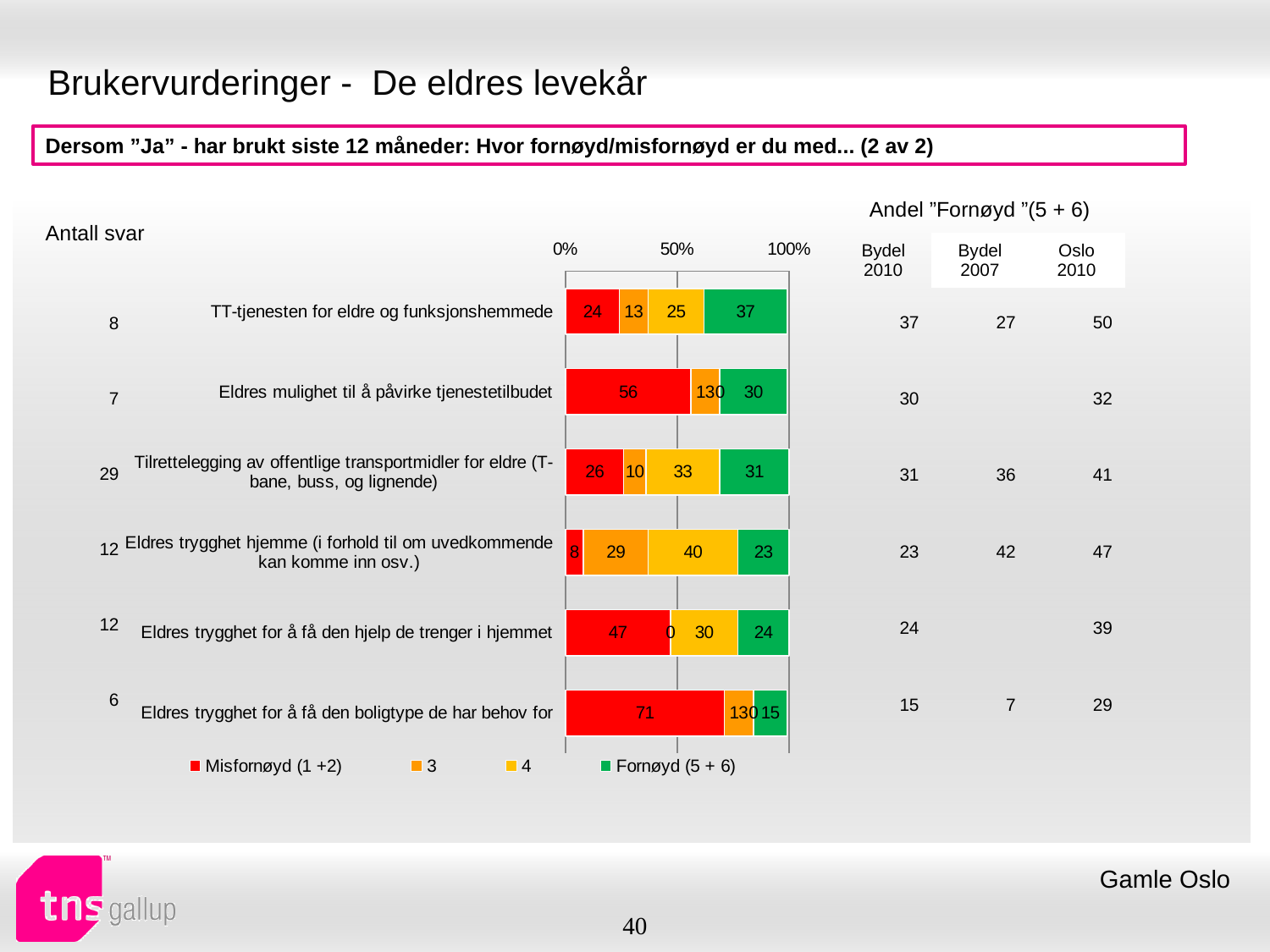
What kind of chart is shown on the slide? Stacked bar chart What is the difference between the Misfornøyd (1 +2) values for "Eldres trygghet for å få den boligtype de har behov for" and "Eldres trygghet for å få den hjelp de trenger i hjemmet"? 24 How many series does the chart legend list? 4 Which is larger: the Misfornøyd (1 +2) value for "Tilrettelegging av offentlige transportmidler for eldre" or for "Eldres trygghet hjemme"? Tilrettelegging av offentlige transportmidler for eldre What is the value of series 4 for "Eldres trygghet hjemme (i forhold til om uvedkommende kan komme inn osv.)"? 40 Which category has the highest Fornøyd (5 + 6) value? TT-tjenesten for eldre og funksjonshemmede Which category has the lowest Fornøyd (5 + 6) value? Eldres trygghet for å få den boligtype de har behov for What is the Fornøyd (5 + 6) value for "TT-tjenesten for eldre og funksjonshemmede"? 37 What is the Misfornøyd (1 +2) value for "Eldres trygghet for å få den boligtype de har behov for"? 71 What colour represents the Fornøyd (5 + 6) series in the chart? Green Is the Misfornøyd (1 +2) value for "Eldres mulighet til å påvirke tjenestetilbudet" greater or less than 50%? greater How many categories are plotted in the chart? 6